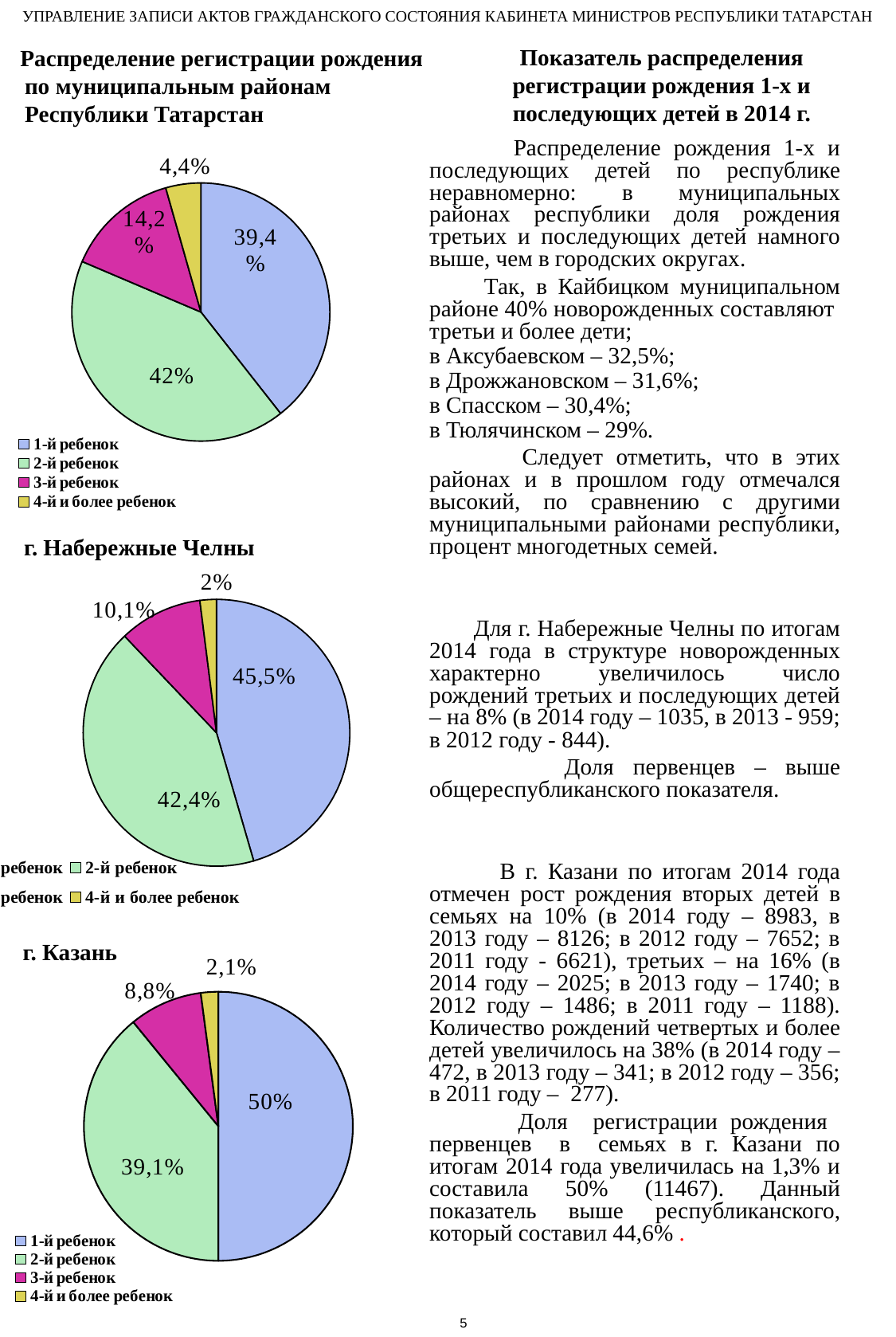
What type of chart is used for г. Набережные Челны? Pie chart How many entries does the legend of the top pie chart (Распределение регистрации рождения по муниципальным районам Республики Татарстан) list? 4 In the pie chart for г. Набережные Челны, what share is shown for 2-й ребенок? 42,4% How many slices does the pie chart for г. Казань have? 4 In the pie chart for г. Казань, what share is shown for 4-й и более ребенок? 2,1% In the top pie chart (Распределение регистрации рождения по муниципальным районам Республики Татарстан), which category has the largest share? 2-й ребенок In the top pie chart (Распределение регистрации рождения по муниципальным районам Республики Татарстан), what is the difference between the shares for 3-й ребенок and 4-й и более ребенок? 9,8% In the pie chart for г. Казань, what is the difference between the shares for 1-й ребенок and 2-й ребенок? 10,9% In the pie chart for г. Казань, what share is shown for 1-й ребенок? 50% In the pie chart for г. Набережные Челны, which is larger: the share for 1-й ребенок or the share for 2-й ребенок? 1-й ребенок In the top pie chart (Распределение регистрации рождения по муниципальным районам Республики Татарстан), what share is shown for 3-й ребенок? 14,2% In the pie chart for г. Набережные Челны, which category has the smallest share? 4-й и более ребенок